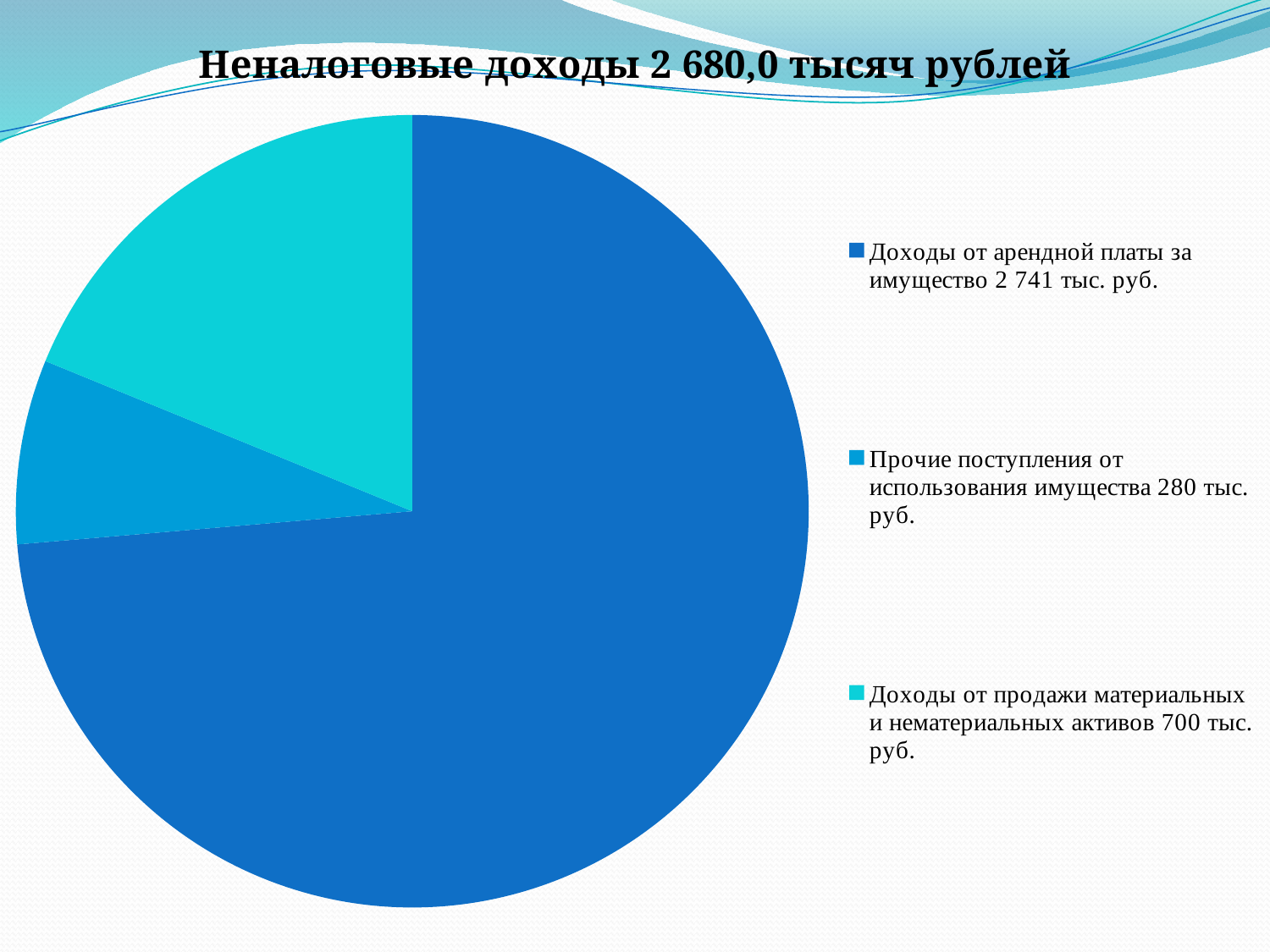
Which is larger: "Доходы от продажи материальных и нематериальных активов" or "Прочие поступления от использования имущества"? Доходы от продажи материальных и нематериальных активов How many slices does the pie chart have? 3 What is the difference between "Доходы от продажи материальных и нематериальных активов" and "Прочие поступления от использования имущества"? 420 тыс. руб. What value is given in the legend for "Доходы от продажи материальных и нематериальных активов"? 700 тыс. руб. Which category has the smallest slice of the pie? Прочие поступления от использования имущества What value is given in the legend for "Доходы от арендной платы за имущество"? 2 741 тыс. руб. What is the difference between "Доходы от арендной платы за имущество" and "Доходы от продажи материальных и нематериальных активов"? 2 041 тыс. руб. What is the title of the chart slide? Неналоговые доходы 2 680,0 тысяч рублей What kind of chart is shown on the slide? Pie chart How many entries does the legend of the pie chart list? 3 Which category has the largest slice of the pie? Доходы от арендной платы за имущество What value is given in the legend for "Прочие поступления от использования имущества"? 280 тыс. руб.